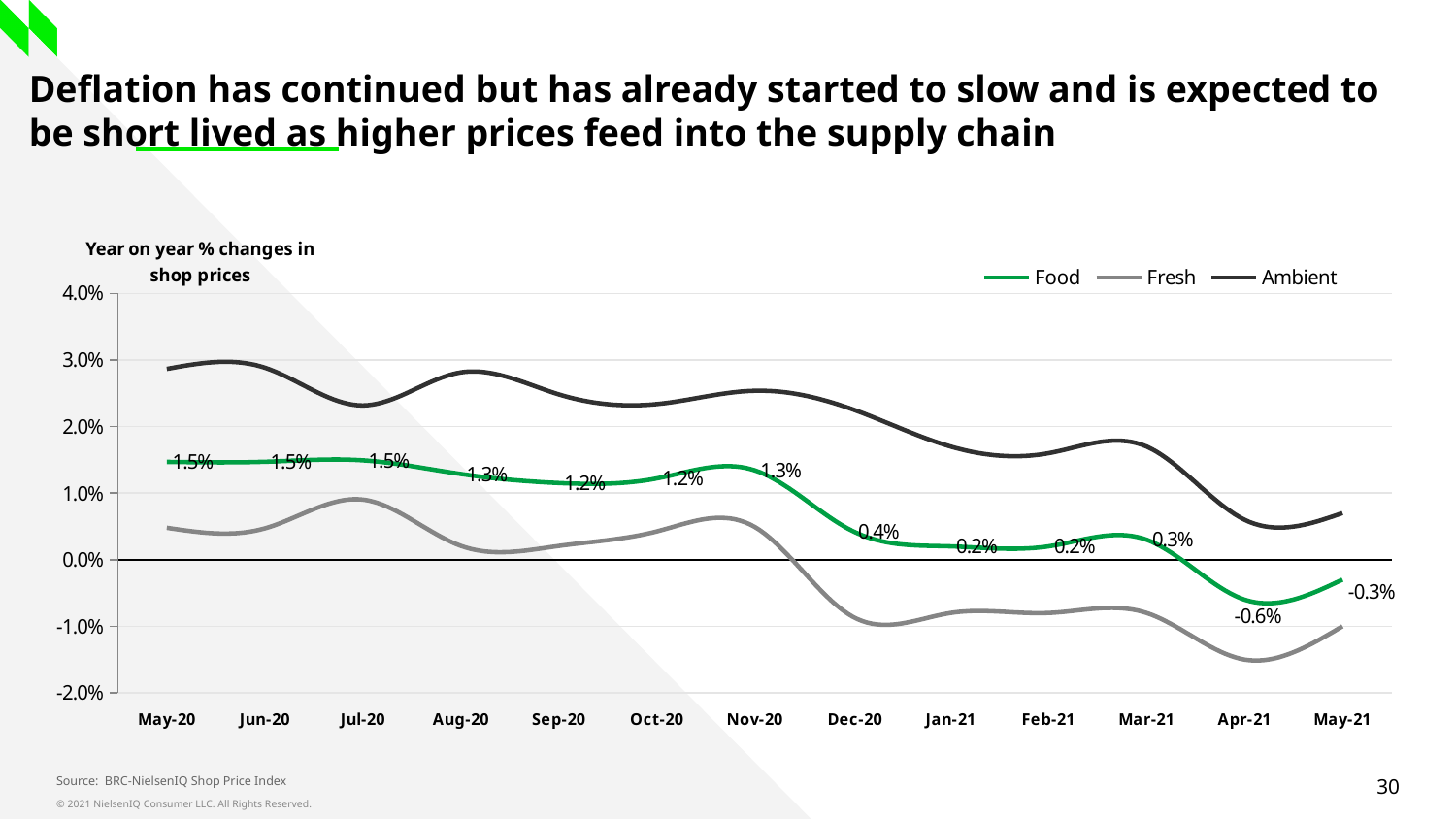
What is the difference between the Food value in May-20 and the Food value in May-21? 1.8% Is the Fresh value for Apr-21 greater or less than -1.0%? less In which month is the Food series at its lowest? Apr-21 What kind of chart is shown on the slide? line chart Is the Ambient value for Apr-21 greater or less than 1.0%? less What is the Food value for May-21? -0.3% How many months are shown on the x axis? 13 How many series does the legend list? 3 Does the Food series generally rise or fall from May-20 to May-21? fall What is the Food value for Dec-20? 0.4% Which is larger for Food: the value in Nov-20 or the value in Dec-20? Nov-20 Is the Ambient value for May-20 greater or less than 2.0%? greater